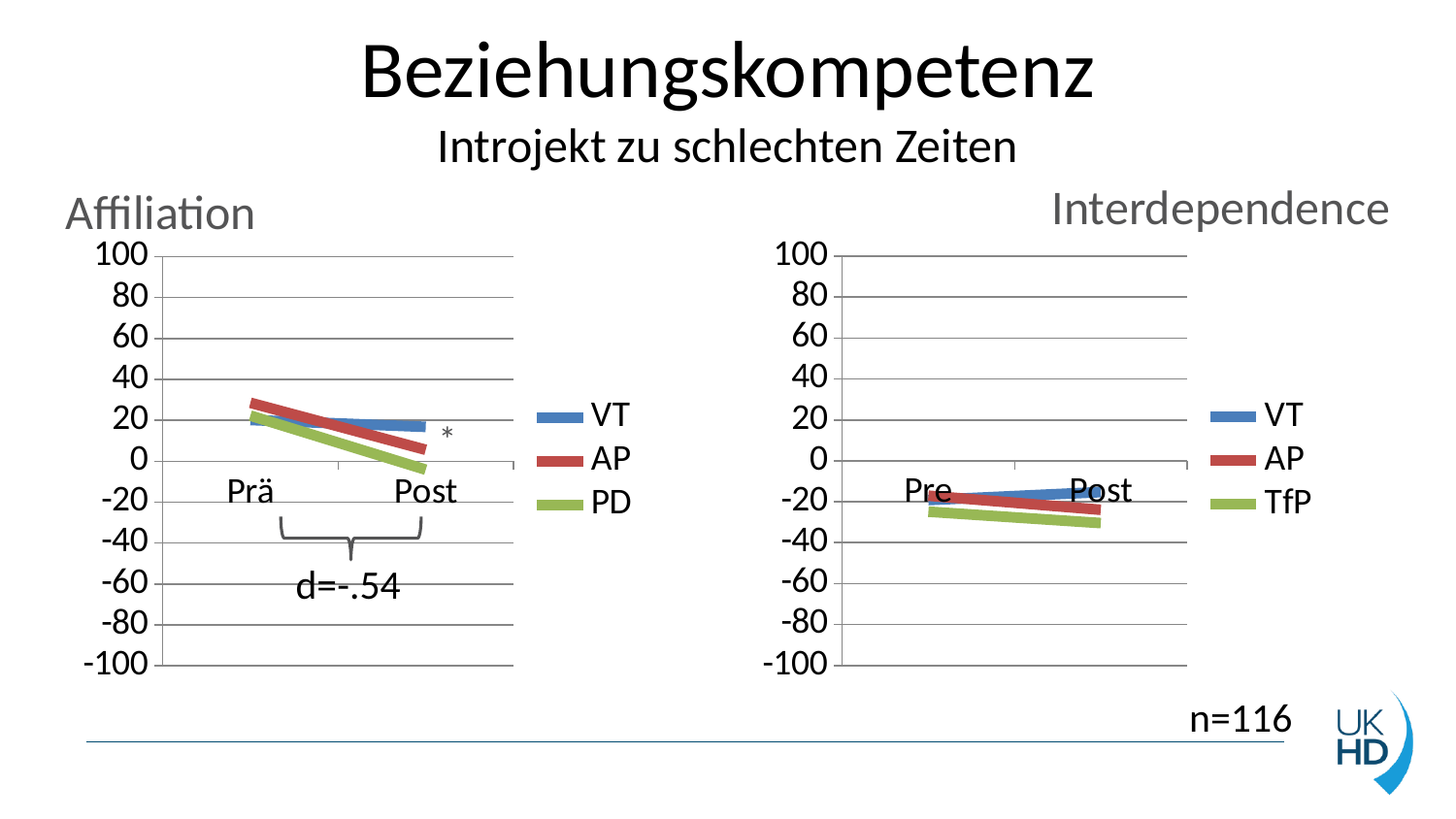
In the Affiliation chart, is the value for AP at Prä greater or less than 20? greater In the Affiliation chart, does the AP series rise or fall from Prä to Post? fall In the Interdependence chart, is the value for TfP at Post greater or less than -20? less What sample size is shown on the slide? n=116 How many x-axis categories does the Affiliation chart have? 2 In the Affiliation chart, which series has the lowest value at Post? PD In the Affiliation chart, does the PD series rise or fall from Prä to Post? fall What type of chart is the Affiliation chart on the left? line chart In the Affiliation chart, which is higher at Post, VT or PD? VT What effect size is annotated below the Affiliation chart? d=-.54 How many series does the legend of the Interdependence chart list? 3 In the Interdependence chart, which series has the lowest value at Post? TfP